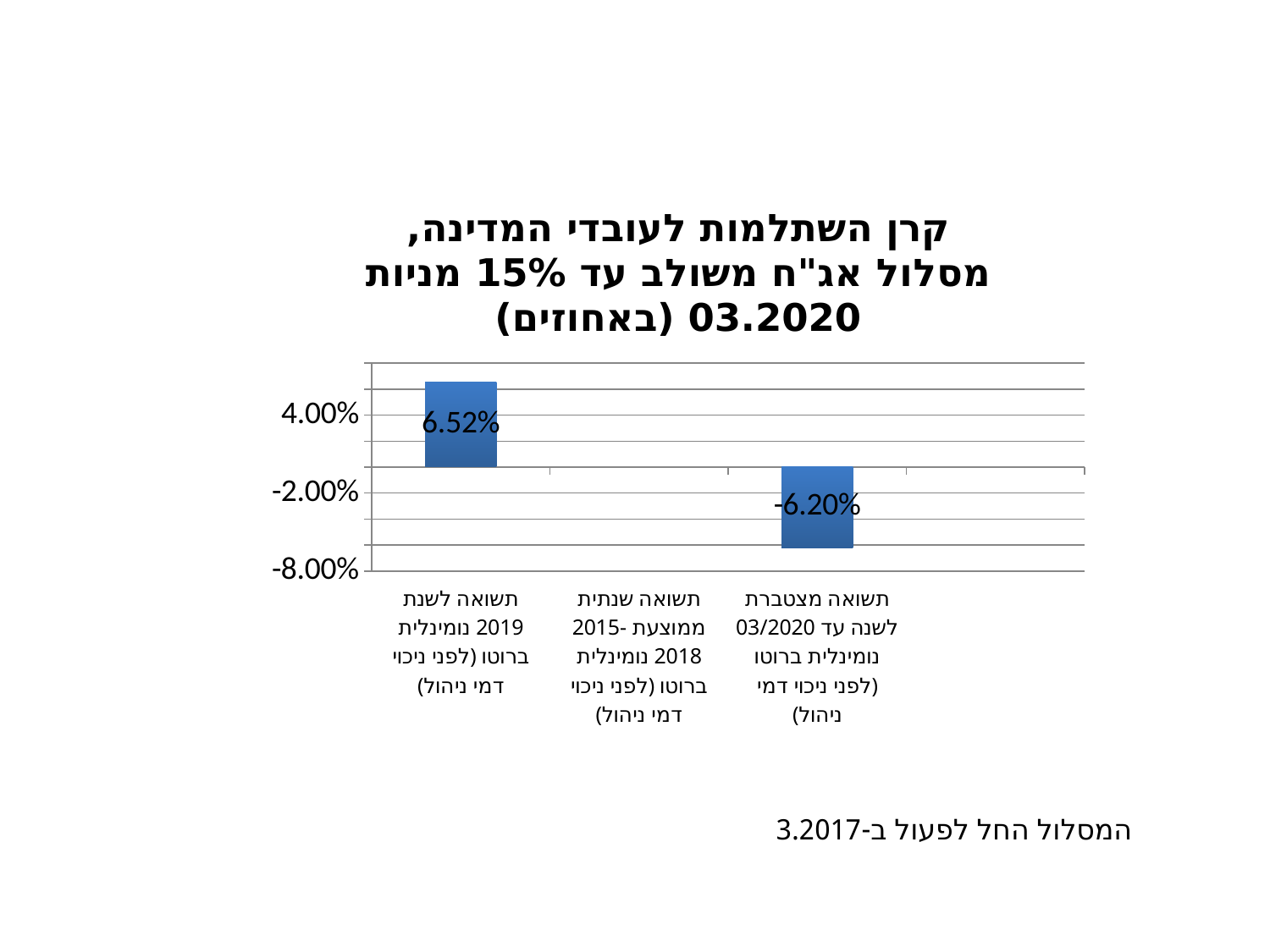
Which category on the x axis has no bar plotted? תשואה שנתית ממוצעת 2015-2018 נומינלית ברוטו (לפני ניכוי דמי ניהול) What is the lowest tick value shown on the y axis of the chart? -8.00% What kind of chart is shown on the slide? Bar chart Which category has the highest value in the chart? תשואה לשנת 2019 נומינלית ברוטו (לפני ניכוי דמי ניהול) Is the value for the 2019 return greater or less than 4.00%? greater What is the difference between the 2019 return (6.52%) and the cumulative return to 03/2020 (-6.20%)? 12.72% Is the value for the cumulative return to 03/2020 greater or less than -2.00%? less Which category has the lowest plotted value in the chart? תשואה מצטברת לשנה עד 03/2020 נומינלית ברוטו (לפני ניכוי דמי ניהול) What is the value shown for the category "תשואה לשנת 2019 נומינלית ברוטו (לפני ניכוי דמי ניהול)" (2019 return)? 6.52% How many categories are shown on the x axis of the chart? 3 Which is larger: the 2019 return or the cumulative return for the year to 03/2020? The 2019 return (6.52%) What is the value shown for the category "תשואה מצטברת לשנה עד 03/2020" (cumulative return for the year to 03/2020)? -6.20%